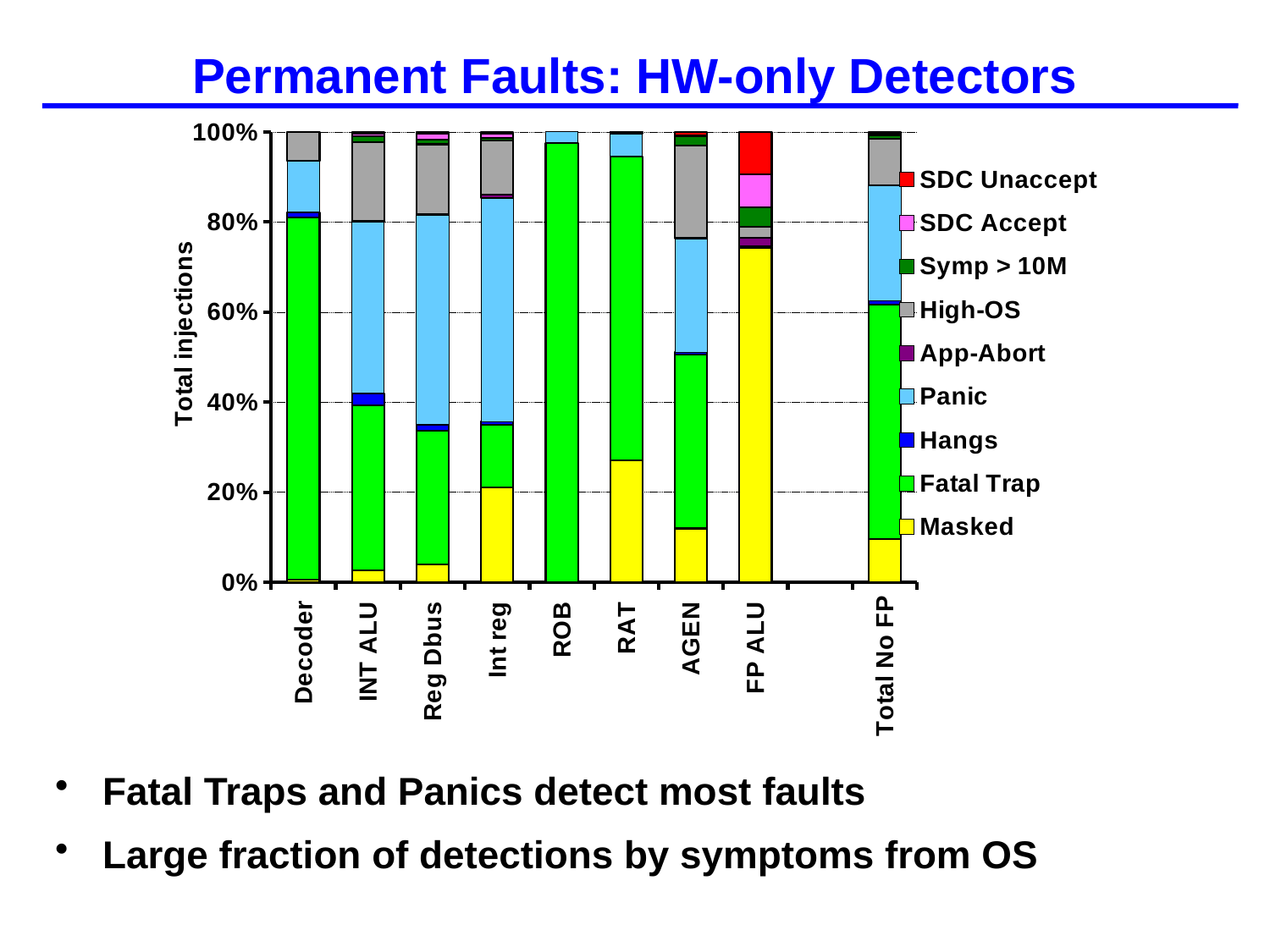
How many categories are shown along the x axis of the chart? 9 What is the title of the y axis? Total injections Which category has the largest Masked share? FP ALU Which category has the largest SDC Unaccept share? FP ALU How many series does the legend list? 9 Is the Fatal Trap value for Decoder greater or less than 60%? greater What kind of chart is shown on the slide? Stacked bar chart Which category has the larger Masked share, RAT or AGEN? RAT Which category has the larger Panic share, Decoder or INT ALU? INT ALU Which category has the largest Fatal Trap share? ROB Is the Masked value for FP ALU greater or less than 60%? greater Is the Masked value for Total No FP greater or less than 20%? less